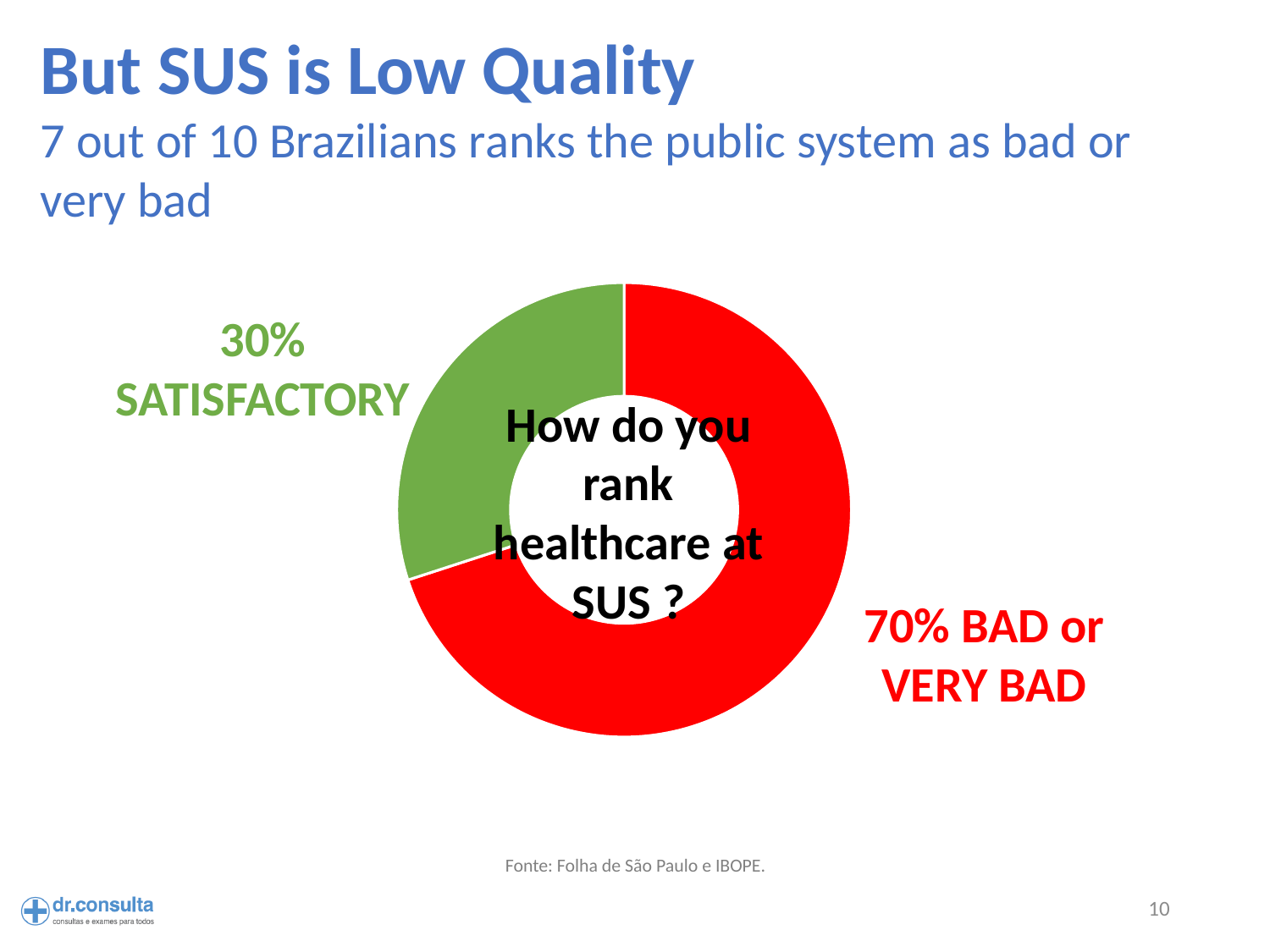
How many categories does the chart show? 2 Which category has the largest share of the chart? BAD or VERY BAD Which category has the smallest share of the chart? SATISFACTORY What share of respondents rank healthcare at SUS as bad or very bad? 70% What share of respondents rank healthcare at SUS as satisfactory? 30% What is the difference in percentage points between the BAD or VERY BAD share and the SATISFACTORY share? 40 What is the total of the two shares shown on the chart? 100% What colour is the SATISFACTORY segment of the chart? Green What kind of chart is shown on the slide? Doughnut (pie) chart What question is written in the centre of the chart? How do you rank healthcare at SUS ? Which is larger, the SATISFACTORY share or the BAD or VERY BAD share? BAD or VERY BAD